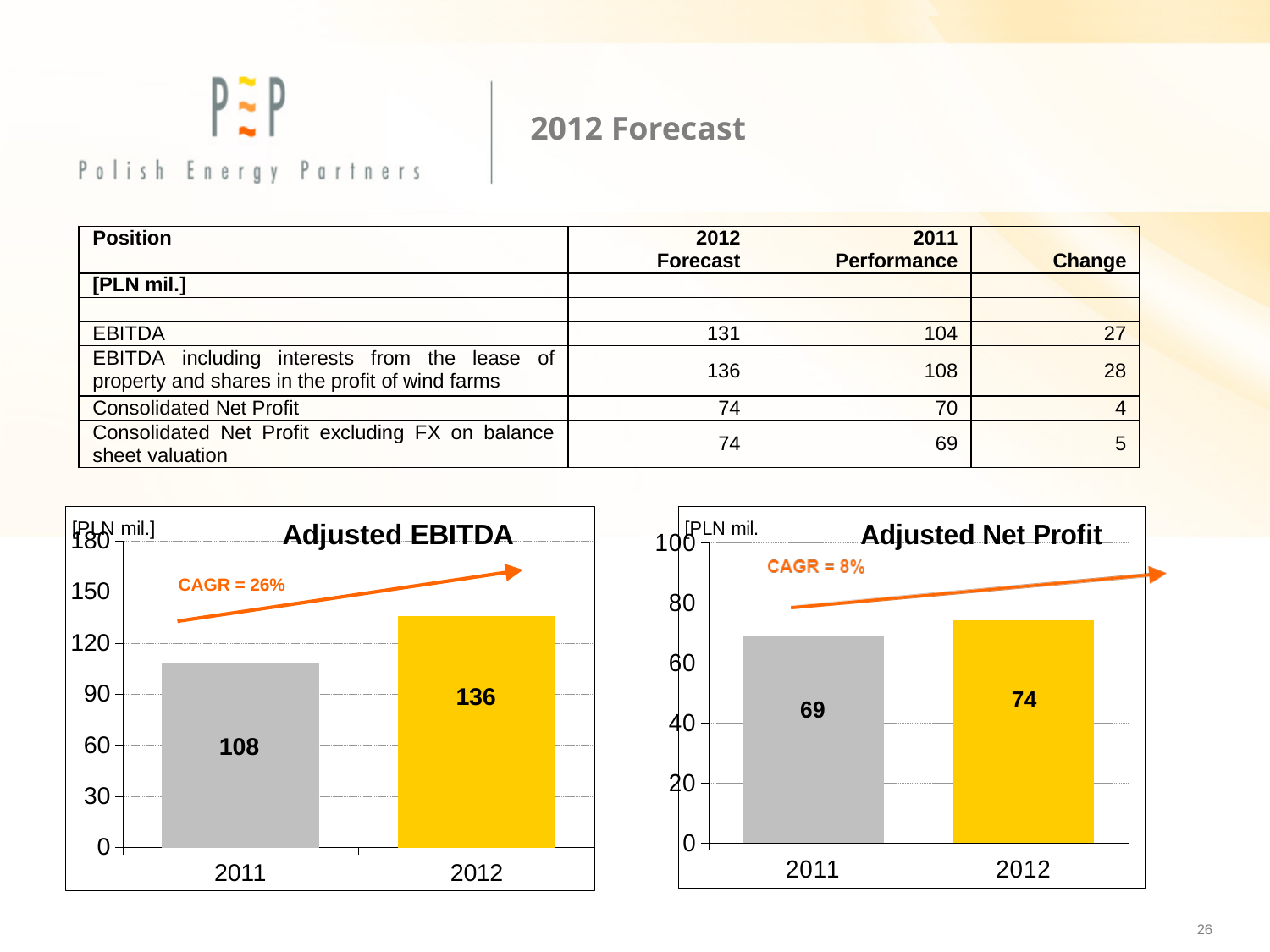
In the Adjusted EBITDA chart, what is the value for 2012? 136 In the Adjusted Net Profit chart, do the values rise or fall from 2011 to 2012? rise In the Adjusted Net Profit chart, what is the value for 2012? 74 In the Adjusted EBITDA chart, which year has the higher value? 2012 In the Adjusted Net Profit chart, what is the difference between the 2012 and 2011 values? 5 In the Adjusted EBITDA chart, is the value for 2011 greater or less than 120? less In the Adjusted Net Profit chart, what is the value for 2011? 69 In the Adjusted EBITDA chart, what is the difference between the 2012 and 2011 values? 28 In the Adjusted Net Profit chart, which year has the lower value? 2011 What kind of chart is the Adjusted EBITDA chart? bar chart What CAGR is shown on the Adjusted EBITDA chart? 26% In the Adjusted EBITDA chart, what is the value for 2011? 108